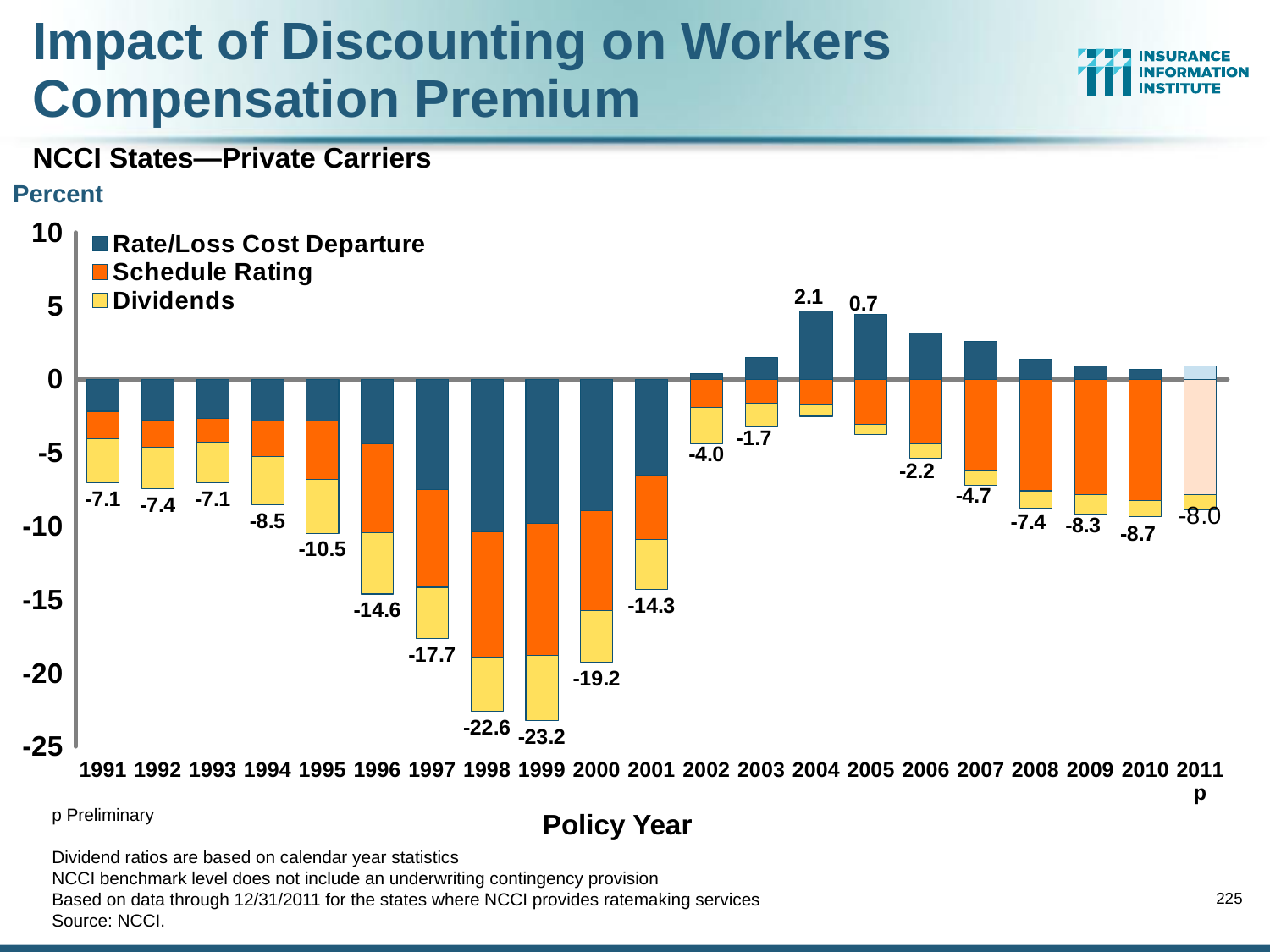
Which series is shown in yellow in the legend? Dividends What is the labeled net value for policy year 2011p? -8.0 How many series does the legend list? 3 Which policy year has a larger labeled net value, 2002 or 2007? 2002 Which policy year has the highest labeled net value? 2004 What is the labeled net value for policy year 1999? -23.2 Do the labeled net values rise or fall from 1991 to 1999? Fall What is the difference between the labeled net values for 1998 and 1999? 0.6 Which policy year has the lowest labeled net value? 1999 How many policy years are shown on the x axis? 21 What is the labeled net value for policy year 2004? 2.1 What kind of chart is shown on the slide? Stacked bar chart